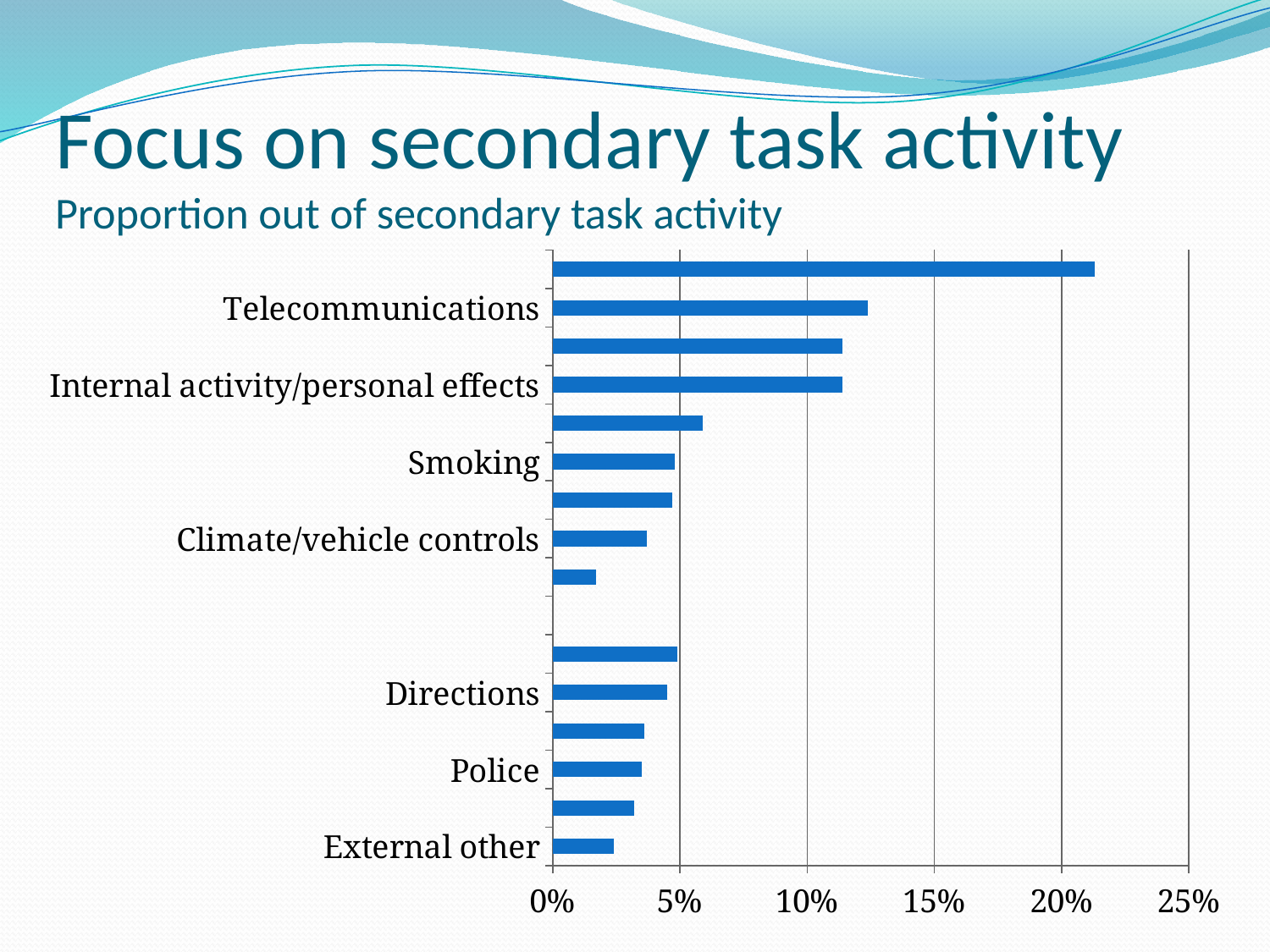
Is the value for Telecommunications greater or less than 15%? less What kind of chart is shown on the slide? bar chart Is the value for External other greater or less than 5%? less Which has the larger value, Climate/vehicle controls or External other? Climate/vehicle controls Is the value for Climate/vehicle controls greater or less than 5%? less What is the highest value shown on the horizontal axis? 25% Which has the larger value, Telecommunications or Smoking? Telecommunications Which has the larger value, Internal activity/personal effects or Police? Internal activity/personal effects What is the title of the chart? Proportion out of secondary task activity